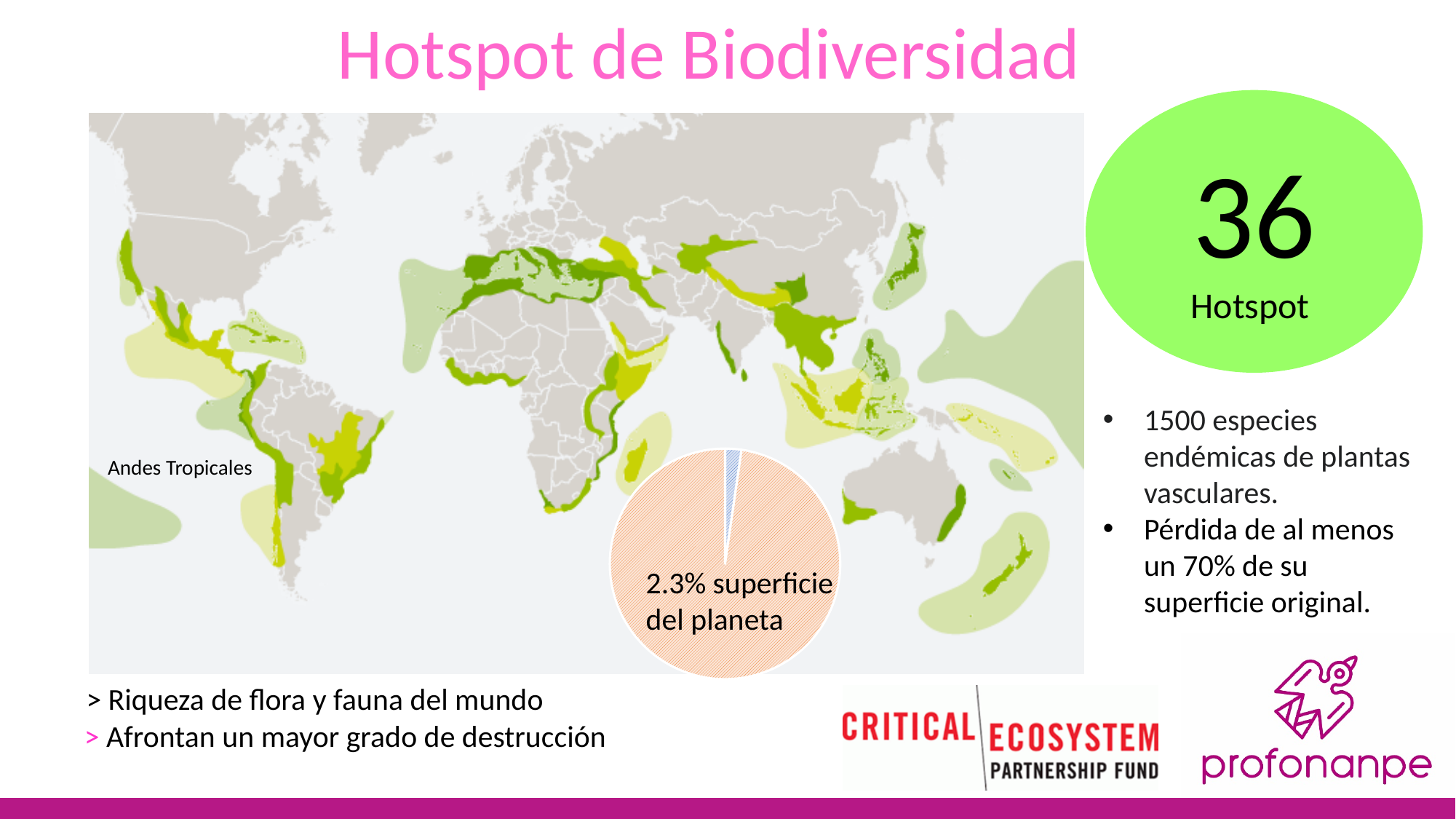
Which is larger in the pie chart, the blue slice or the orange slice? the orange slice Which slice of the pie chart is the largest? the orange slice How many slices does the pie chart have? 2 What colour is the small slice of the pie chart? blue What kind of chart is shown on the slide? pie chart What text label is printed on the pie chart? 2.3% superficie del planeta Which slice of the pie chart is the smallest? the blue slice What share of the planet's surface does the small slice of the pie chart represent? 2.3%